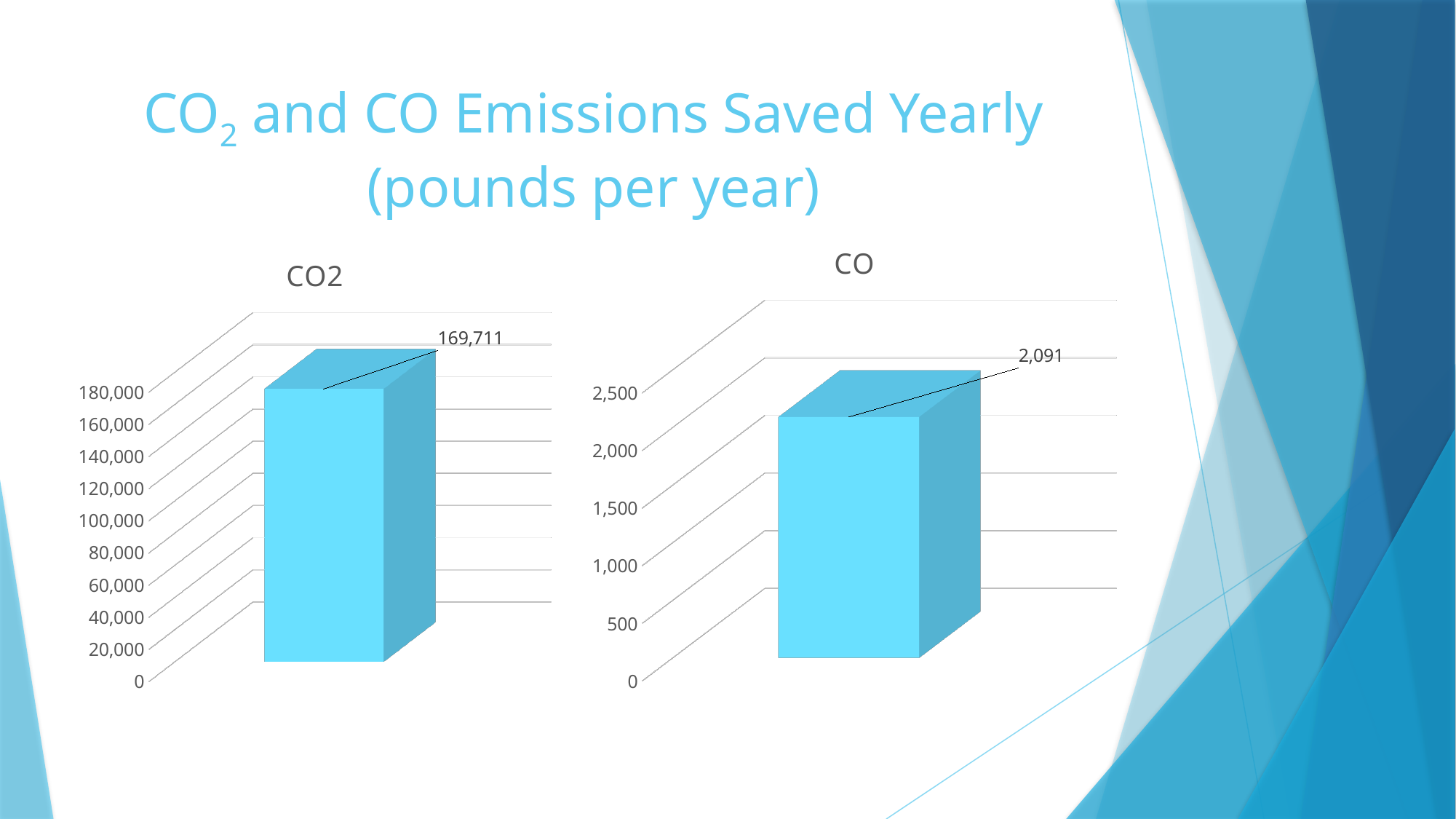
What is the highest tick label on the vertical axis of the CO chart? 2,500 What kind of chart is the CO2 chart? bar chart In the CO chart, is the value of the bar greater or less than 2,500? less In the CO2 chart, what value is shown by the data label on the bar? 169,711 In the CO2 chart, is the value of the bar greater or less than 160,000? greater In the CO chart, what value is shown by the data label on the bar? 2,091 What is the title of the chart on the left? CO2 What kind of chart is the CO chart? bar chart How many bars are plotted in the CO chart? 1 How many bars are plotted in the CO2 chart? 1 Which is larger: the value in the CO2 chart or the value in the CO chart? CO2 chart What is the difference between the value in the CO2 chart and the value in the CO chart? 167,620